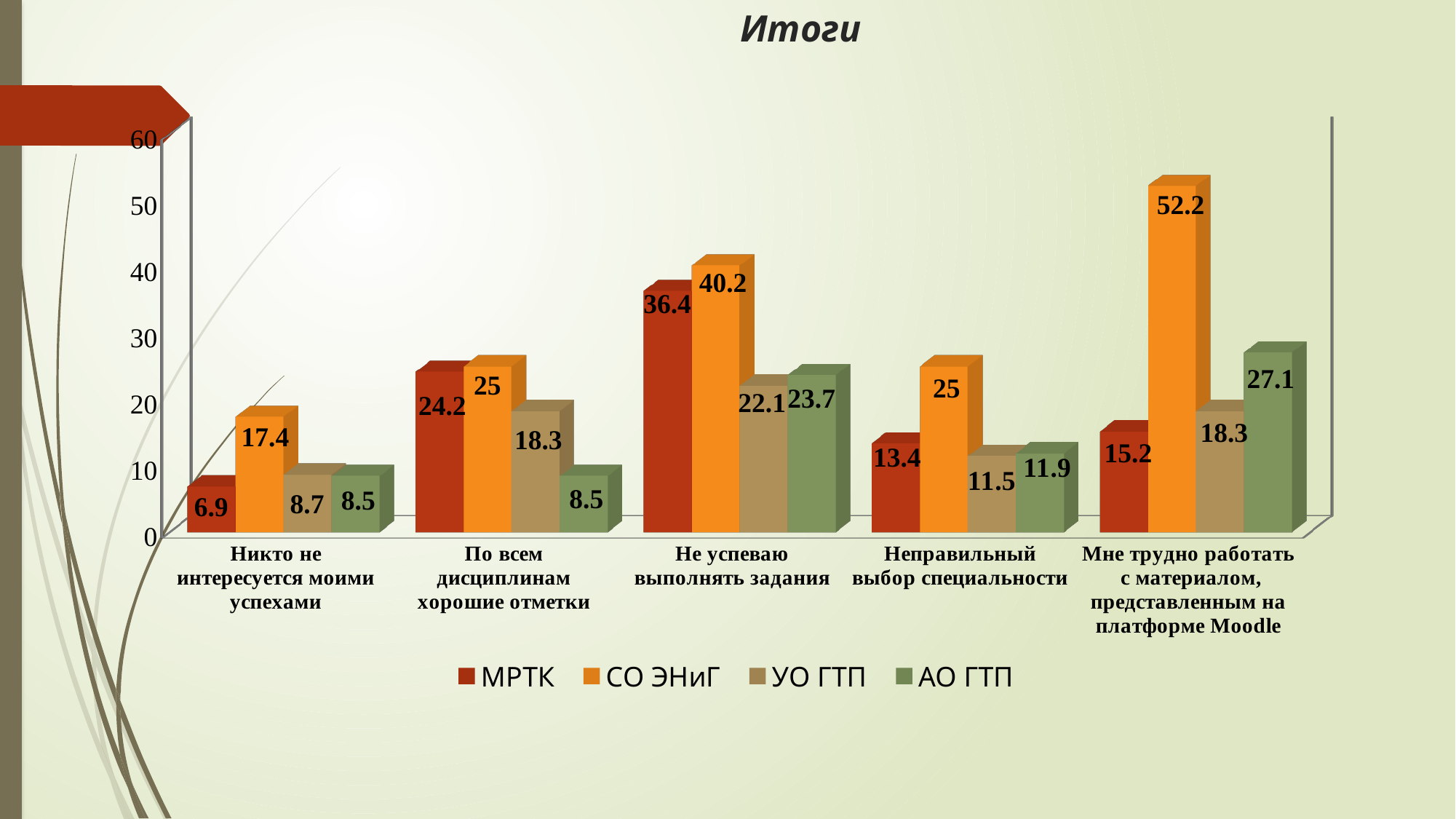
What is the value for АО ГТП in the category "Неправильный выбор специальности"? 11.9 How many series does the legend list? 4 What kind of chart is shown on the slide? Bar chart What is the value for УО ГТП in the category "По всем дисциплинам хорошие отметки"? 18.3 Which series has the highest value in the category "Никто не интересуется моими успехами"? СО ЭНиГ Which is larger in the category "Мне трудно работать с материалом, представленным на платформе Moodle": the value for УО ГТП or for АО ГТП? АО ГТП Which series has the lowest value in the category "По всем дисциплинам хорошие отметки"? АО ГТП What is the value for СО ЭНиГ in the category "Мне трудно работать с материалом, представленным на платформе Moodle"? 52.2 What is the difference between the СО ЭНиГ and МРТК values in the category "Не успеваю выполнять задания"? 3.8 How many categories are shown on the x axis of the chart? 5 Is the value for СО ЭНиГ in the category "Мне трудно работать с материалом, представленным на платформе Moodle" greater or less than 50? greater What is the value for МРТК in the category "Не успеваю выполнять задания"? 36.4